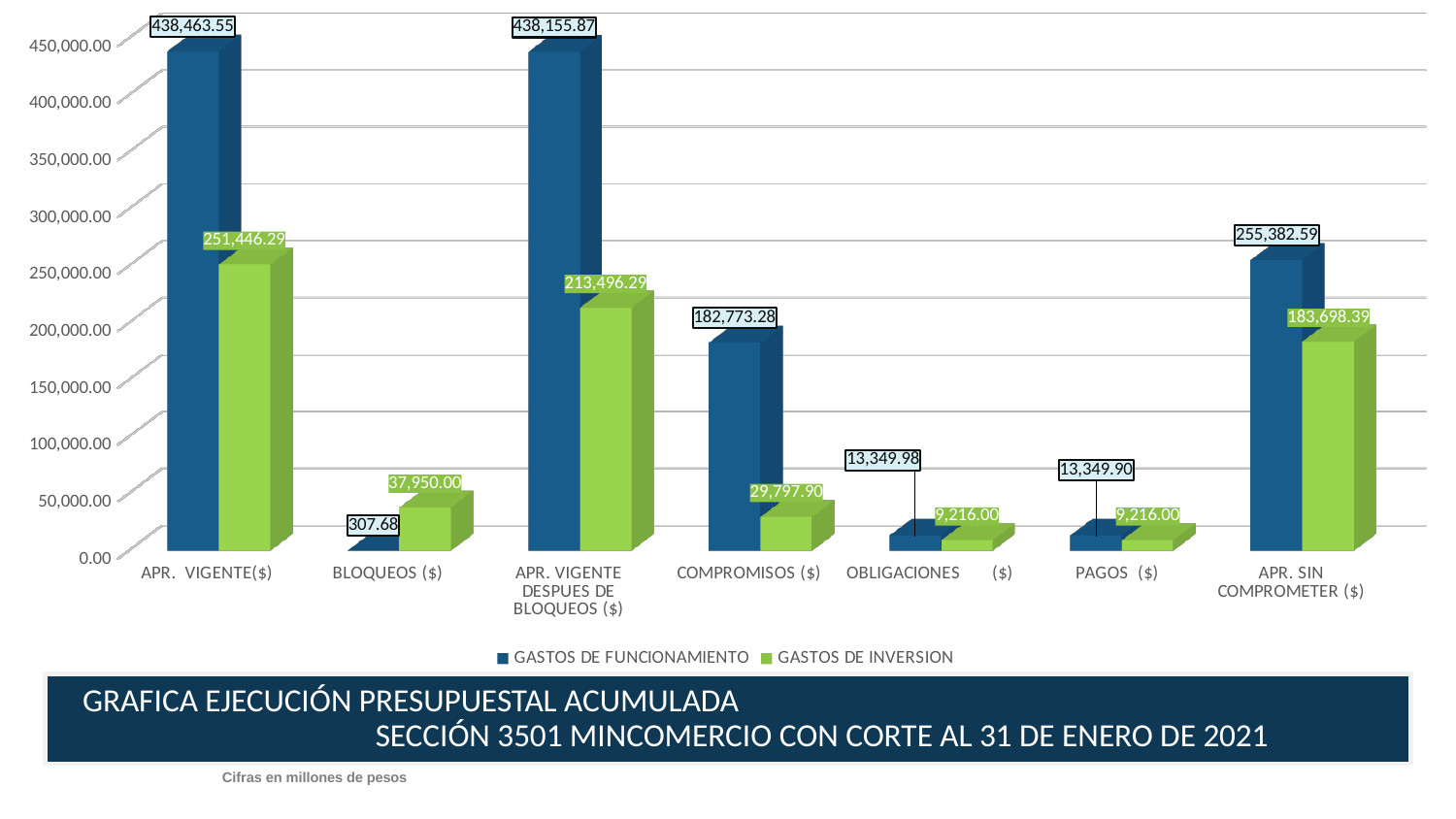
What is the difference between GASTOS DE FUNCIONAMIENTO and GASTOS DE INVERSION for APR. SIN COMPROMETER ($)? 71,684.20 What is the difference between the GASTOS DE INVERSION values for APR. VIGENTE($) and APR. VIGENTE DESPUES DE BLOQUEOS ($)? 37,950.00 For BLOQUEOS ($), which series has the larger value, GASTOS DE FUNCIONAMIENTO or GASTOS DE INVERSION? GASTOS DE INVERSION How many categories are shown on the x axis? 7 What is the value of GASTOS DE INVERSION for APR. SIN COMPROMETER ($)? 183,698.39 What is the value of GASTOS DE FUNCIONAMIENTO for COMPROMISOS ($)? 182,773.28 Which category has the highest GASTOS DE INVERSION value? APR. VIGENTE($) What is the value of GASTOS DE FUNCIONAMIENTO for APR. VIGENTE($)? 438,463.55 How many series does the legend list? 2 What kind of chart is shown on the slide? Bar chart Which category has the lowest GASTOS DE FUNCIONAMIENTO value? BLOQUEOS ($) What is the value of GASTOS DE INVERSION for BLOQUEOS ($)? 37,950.00